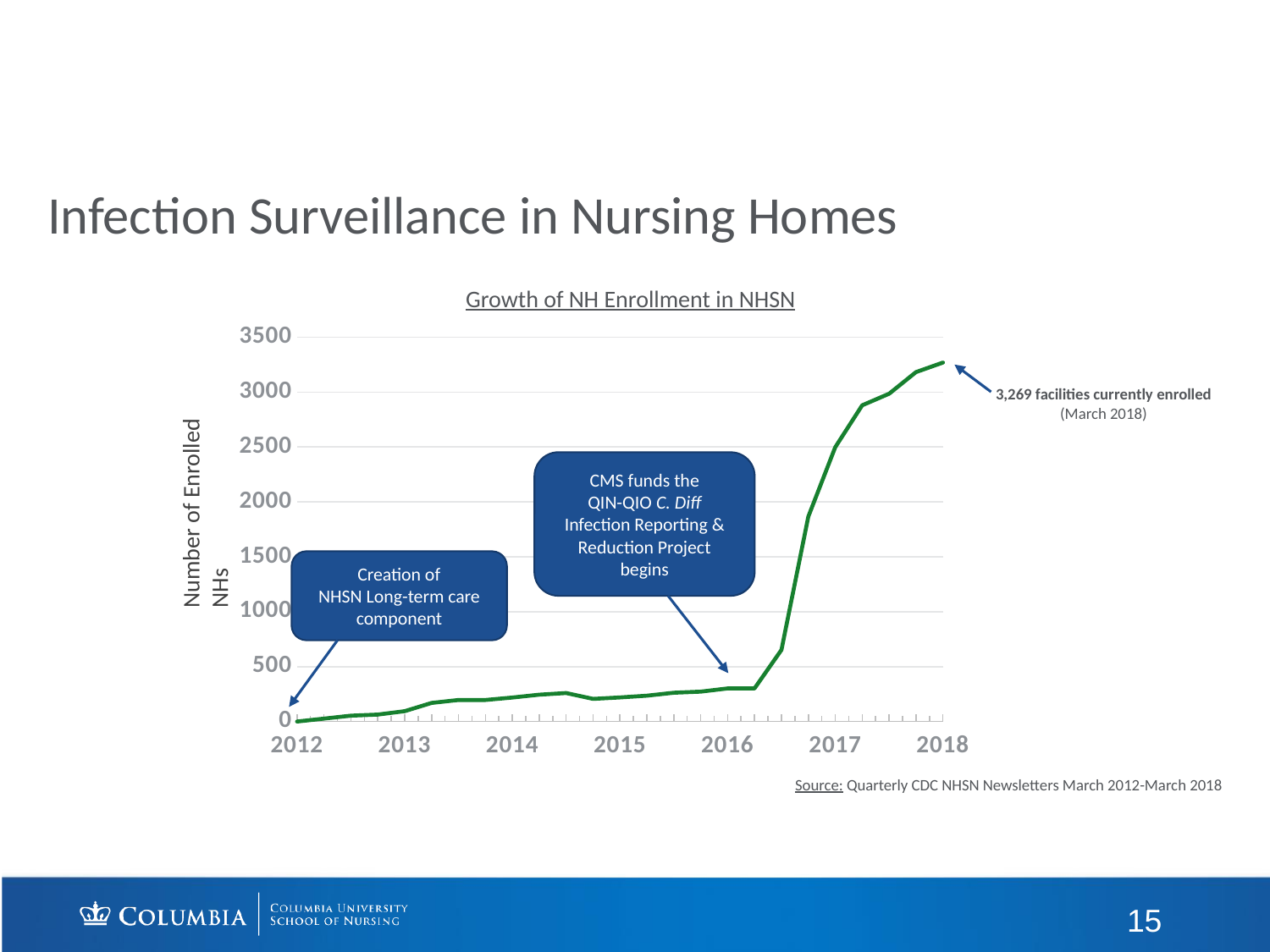
At which year label on the x axis is enrollment lowest? 2012 Is the value at 2014 greater or less than 500? less Which year has the higher enrollment, 2016 or 2017? 2017 How many year labels are shown on the x axis? 7 What is the title of the chart? Growth of NH Enrollment in NHSN How many facilities were enrolled as of March 2018, according to the annotation? 3,269 What kind of chart is shown on the slide? line chart Is the value at 2016 greater or less than 500? less Is the value at 2017 greater or less than 2000? greater What is the label of the vertical axis? Number of Enrolled NHs Does the number of enrolled nursing homes rise or fall from 2012 to 2018? rise